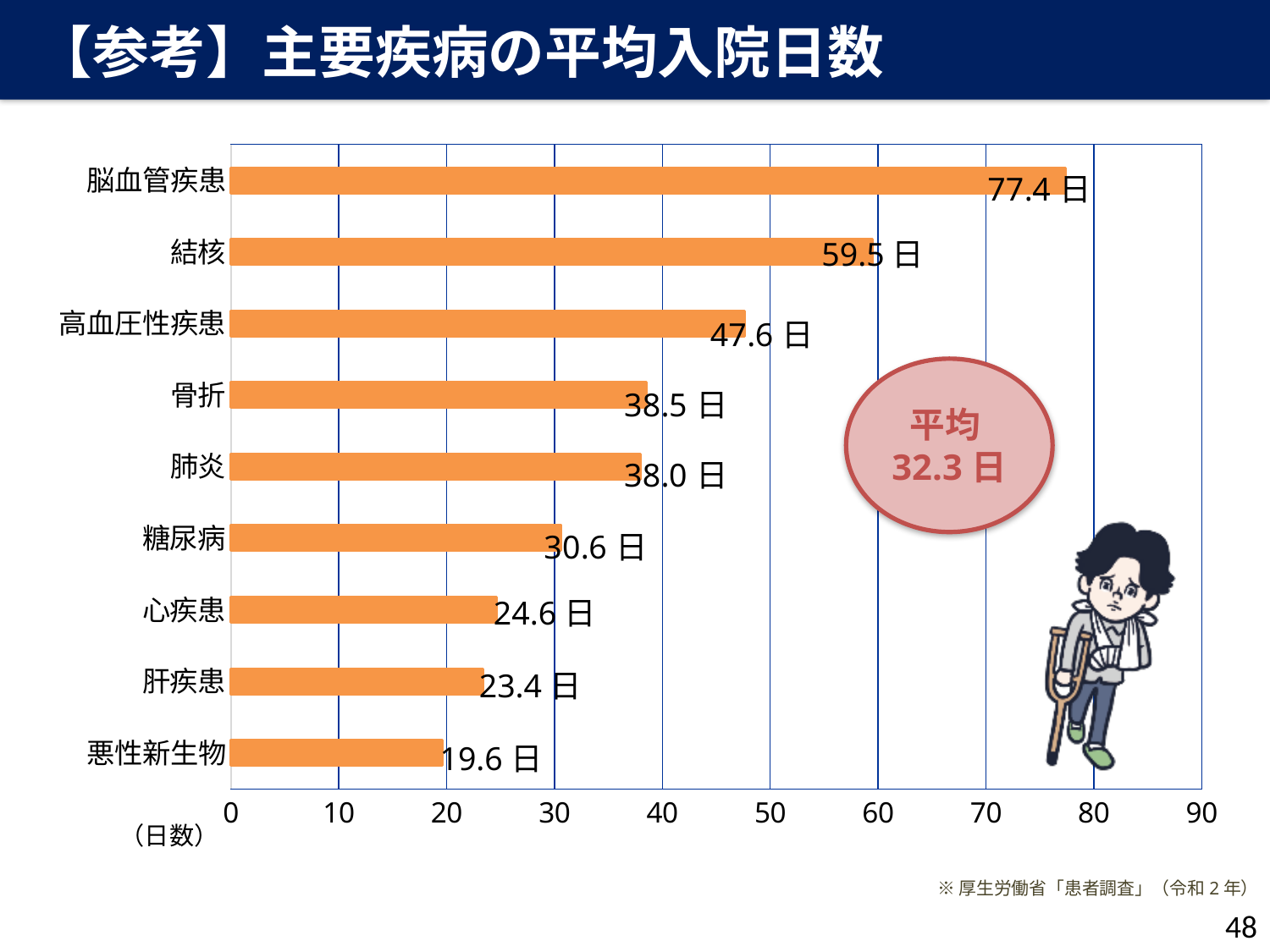
What is the title of the slide? 【参考】主要疾病の平均入院日数 What is the average hospital stay for 悪性新生物? 19.6 日 Which disease has the shortest average hospital stay? 悪性新生物 What is the average hospital stay for 糖尿病? 30.6 日 What overall average number of hospital days is shown in the circle on the chart? 32.3 日 What is the difference in average hospital stay between 結核 and 高血圧性疾患? 11.9 日 What kind of chart is shown on the slide? bar chart Is the value for 肺炎 greater or less than 40? less Which disease has the longest average hospital stay? 脳血管疾患 How many diseases are shown in the chart? 9 What is the average hospital stay for 脳血管疾患? 77.4 日 Which has a longer average hospital stay, 心疾患 or 肝疾患? 心疾患